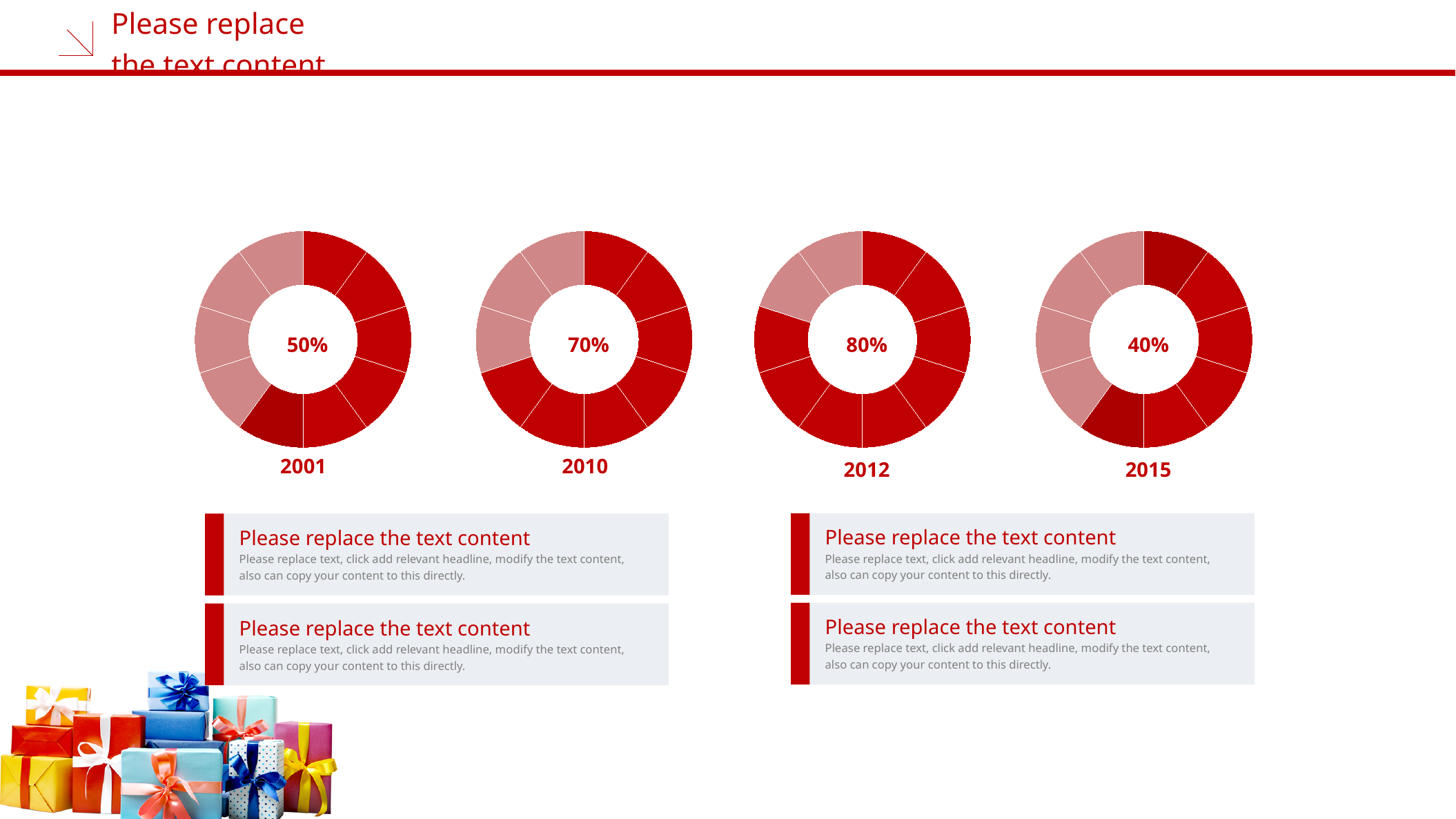
How many donut charts are shown on the slide? 4 What kind of chart is used to show the percentage for each year? Donut chart What percentage is shown in the centre of the donut chart labelled 2001? 50% Which year label appears under the donut chart furthest to the right? 2015 What percentage is shown in the centre of the donut chart labelled 2010? 70% Which year's donut chart shows the lowest percentage? 2015 What is the difference between the percentage shown for 2010 and the percentage shown for 2015? 30% Which is larger, the percentage shown for 2010 or the percentage shown for 2015? 2010 What is the difference between the percentage shown for 2012 and the percentage shown for 2001? 30% What percentage is shown in the centre of the donut chart labelled 2015? 40% Which year's donut chart shows the highest percentage? 2012 What percentage is shown in the centre of the donut chart labelled 2012? 80%